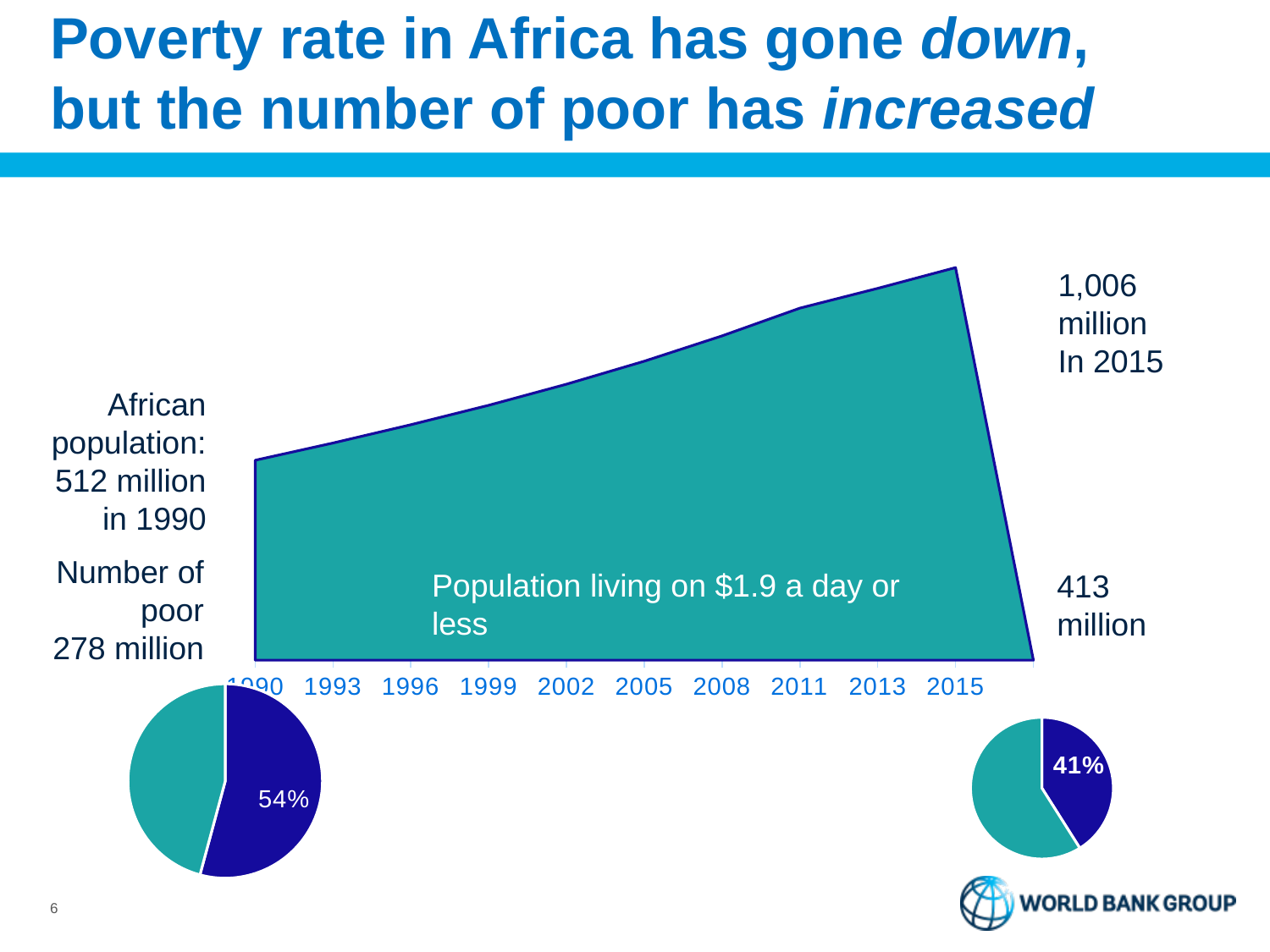
According to the area chart, what was the number of poor in 1990? 278 million In the pie chart at the bottom right, what share is shown for the dark blue slice? 41% According to the area chart, what was the African population in 1990? 512 million Which pie chart has the larger dark blue slice, the one at the bottom left or the one at the bottom right? Bottom left According to the area chart, what was the number of poor in 2015? 413 million What label is printed inside the shaded area of the area chart? Population living on $1.9 a day or less According to the area chart, what was the African population in 2015? 1,006 million What kind of chart is the large chart in the middle of the slide? Area chart In the pie chart at the bottom left, what share is shown for the dark blue slice? 54% How many year labels are shown on the x axis of the area chart? 10 By how much did the number of poor increase between 1990 and 2015 according to the area chart? 135 million In the area chart, does the plotted value rise or fall from 1990 to 2015? Rise